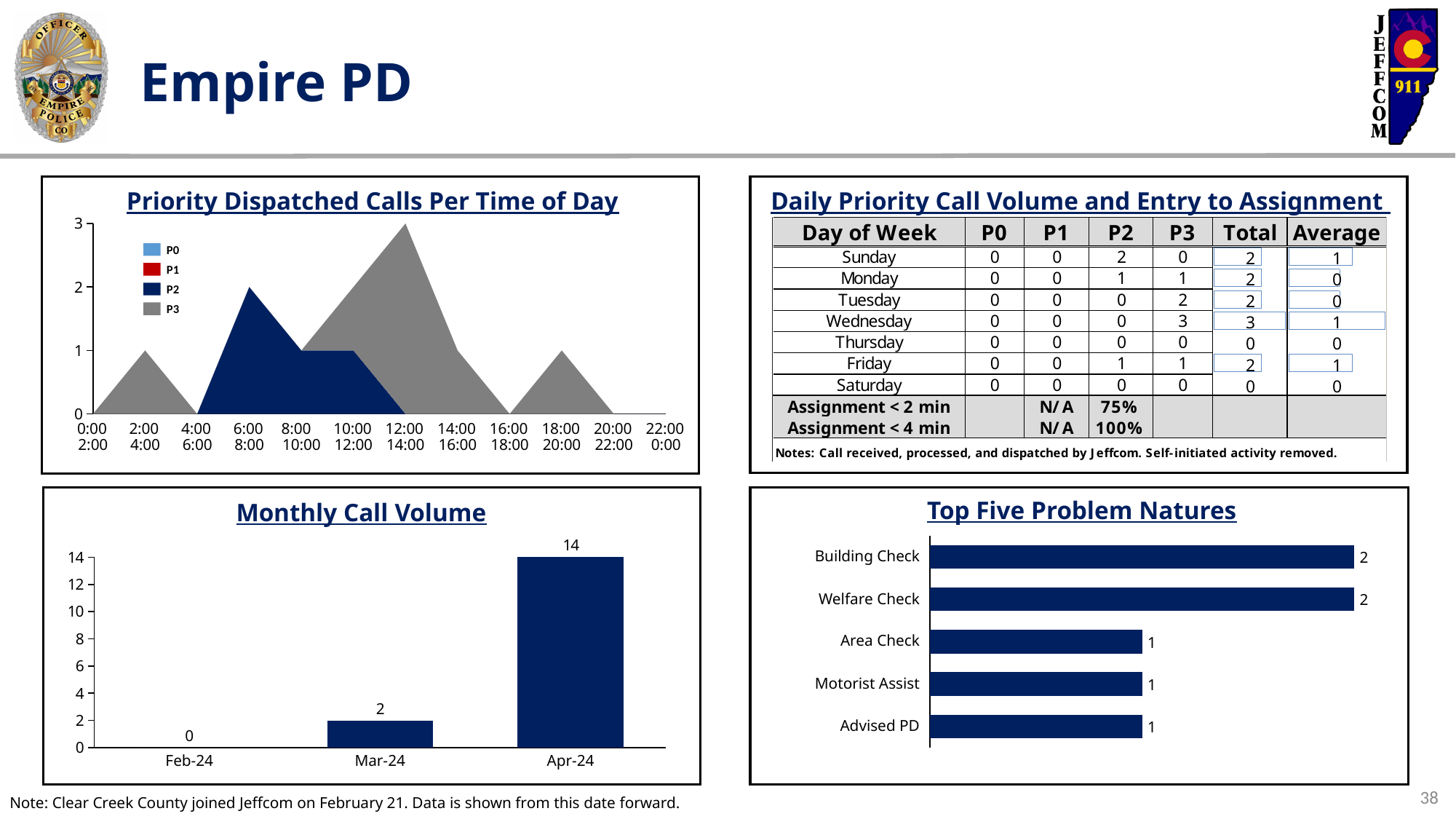
In the Top Five Problem Natures chart, which is larger, Building Check or Area Check? Building Check In the Monthly Call Volume chart, what is the value for Mar-24? 2 What kind of chart is the Monthly Call Volume chart? bar chart In the Monthly Call Volume chart, what is the difference between the Apr-24 and Mar-24 values? 12 In the Monthly Call Volume chart, what is the value for Apr-24? 14 In the Monthly Call Volume chart, which month has the lowest call volume? Feb-24 In the Monthly Call Volume chart, which month has the highest call volume? Apr-24 In the Top Five Problem Natures chart, how many problem natures are shown? 5 In the Top Five Problem Natures chart, what is the value for Welfare Check? 2 How many series does the legend of the Priority Dispatched Calls Per Time of Day chart list? 4 In the Monthly Call Volume chart, do the values rise or fall from Feb-24 to Apr-24? rise In the Priority Dispatched Calls Per Time of Day chart, what is the P3 value at 12:00-14:00? 3